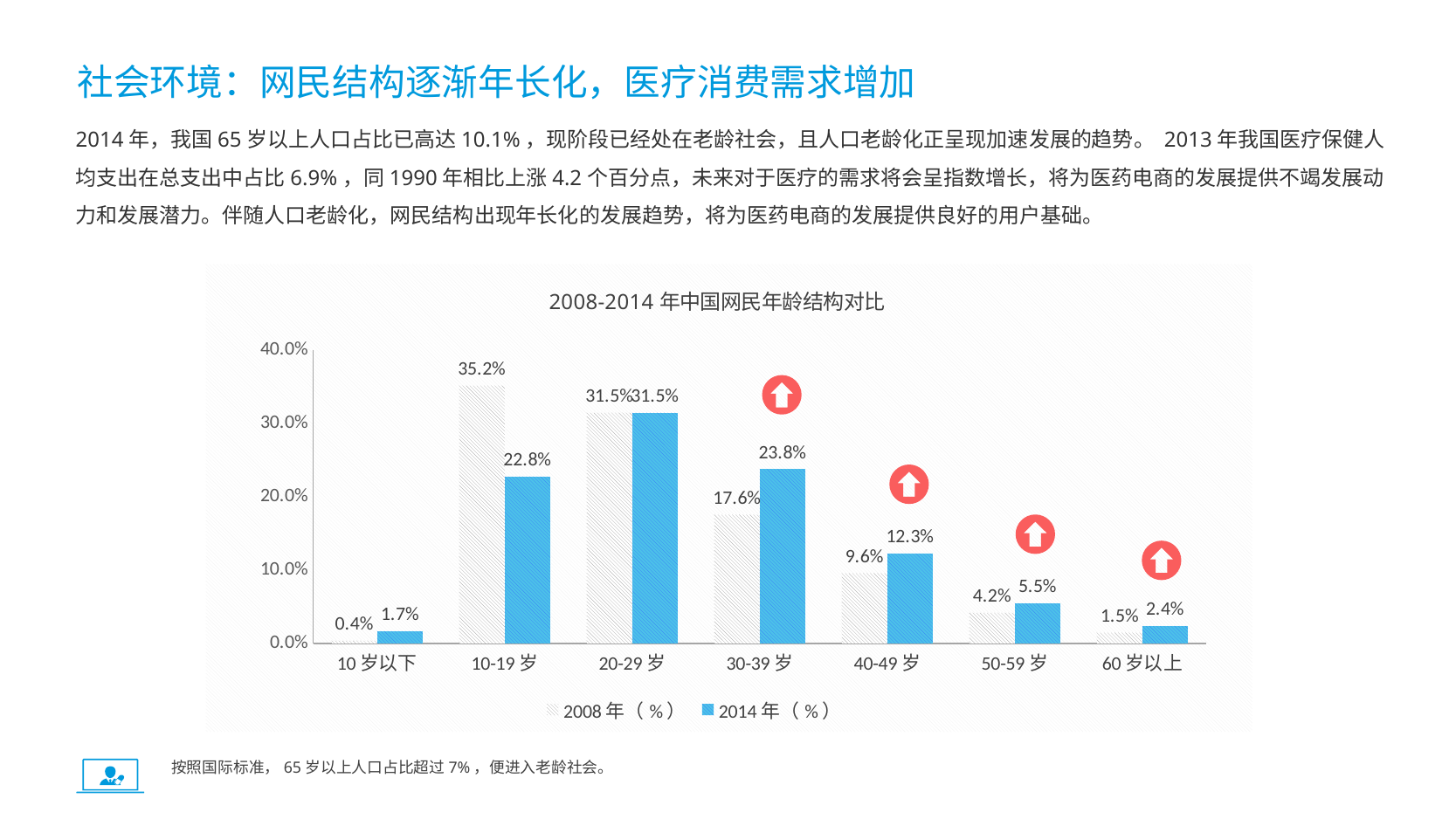
What is the 2014 年 value for the 60 岁以上 age group? 2.4% What is the difference between the 2014 年 and 2008 年 values for the 50-59 岁 age group? 1.3% What is the 2008 年 value for the 10-19 岁 age group? 35.2% How many age groups are shown on the x axis? 7 What kind of chart is shown on the slide? Bar chart What is the difference between the 2008 年 and 2014 年 values for the 10-19 岁 age group? 12.4% What is the 2014 年 value for the 30-39 岁 age group? 23.8% Which age group has the highest 2008 年 value? 10-19 岁 Which age group has the lowest 2014 年 value? 10 岁以下 What is the title of the chart? 2008-2014 年中国网民年龄结构对比 How many series does the legend list? 2 For the 40-49 岁 age group, which is larger: the 2008 年 value or the 2014 年 value? 2014 年